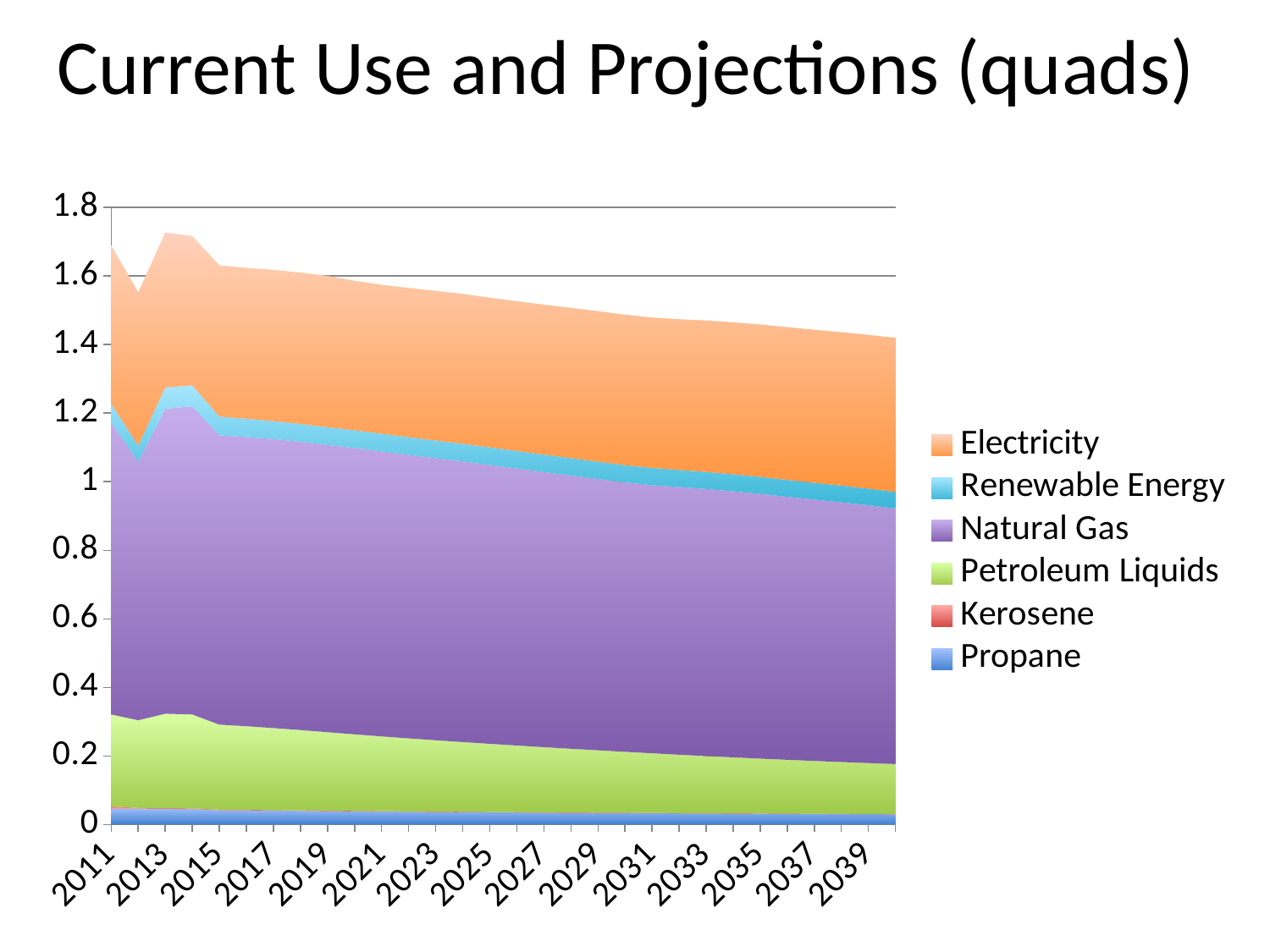
What kind of chart is shown on the slide? Stacked area chart Which series is listed first (at the top) in the legend? Electricity What is the title of the chart? Current Use and Projections (quads) How many series does the legend list? 6 Which series is larger in 2039, Natural Gas or Petroleum Liquids? Natural Gas Is the combined value of Propane, Kerosene, Petroleum Liquids and Natural Gas in 2011 greater or less than 1? greater Is the total stacked value for 2011 greater or less than 1.6? greater Is the total stacked value for 2039 greater or less than 1.2? greater Which series occupies the largest area of the chart? Natural Gas Does the total stacked value rise or fall from 2011 to 2039? Fall Which year has the larger total stacked value, 2011 or 2039? 2011